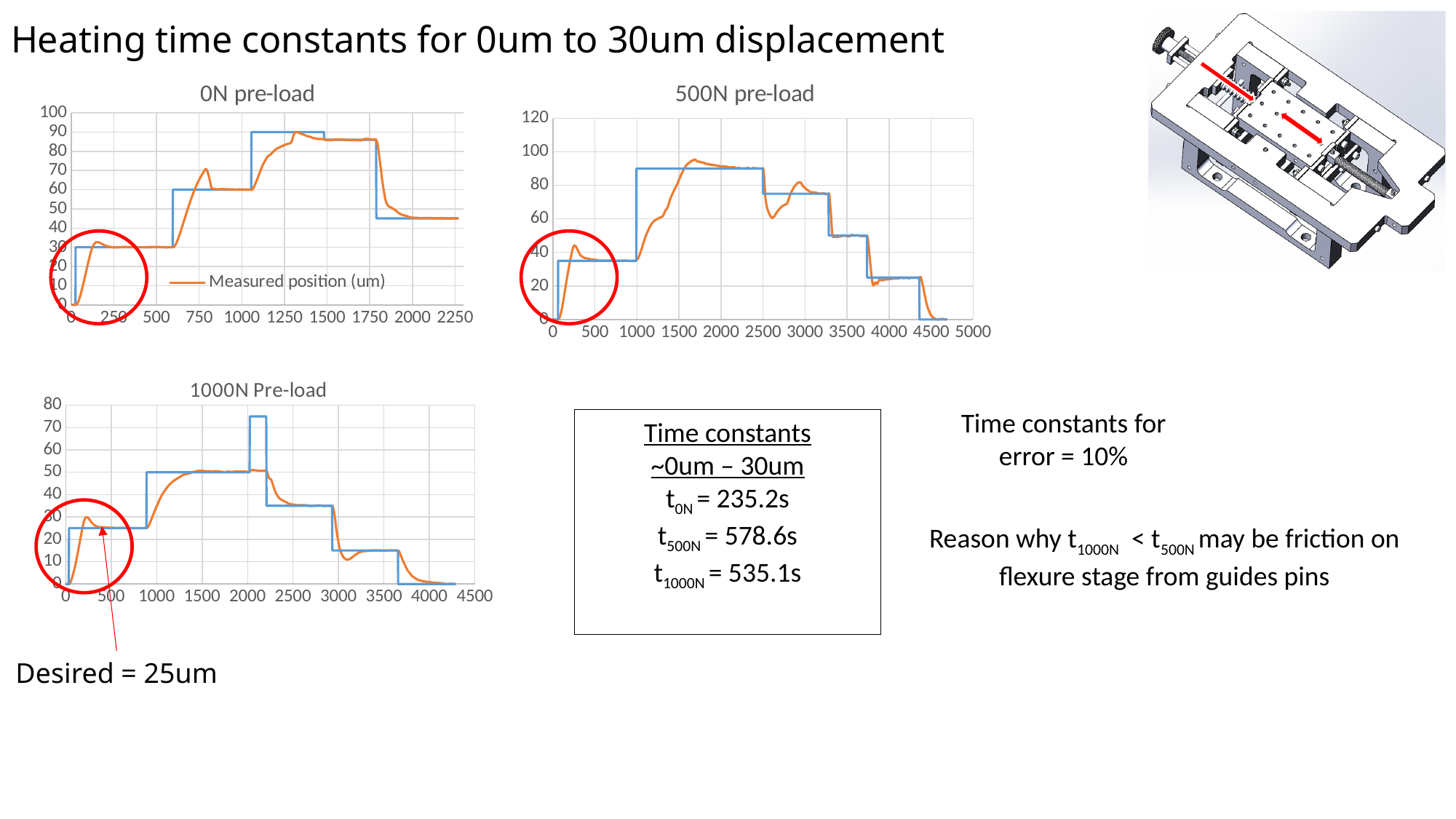
In the "500N pre-load" chart, is the measured position at x = 4000 greater or less than 40? less What is the highest value shown on the y axis of the "500N pre-load" chart? 120 How many charts are shown on the slide? 3 In the "1000N Pre-load" chart, is the measured position at x = 1500 greater or less than 40? greater In the "500N pre-load" chart, does the measured position rise or fall between x = 1000 and x = 1500? rise In the "1000N Pre-load" chart, is the measured position at x = 4000 greater or less than 10? less In the "0N pre-load" chart, what series name does the legend show? Measured position (um) What kind of chart is the "0N pre-load" chart? line chart In the "1000N Pre-load" chart, does the measured position rise or fall between x = 3000 and x = 4000? fall